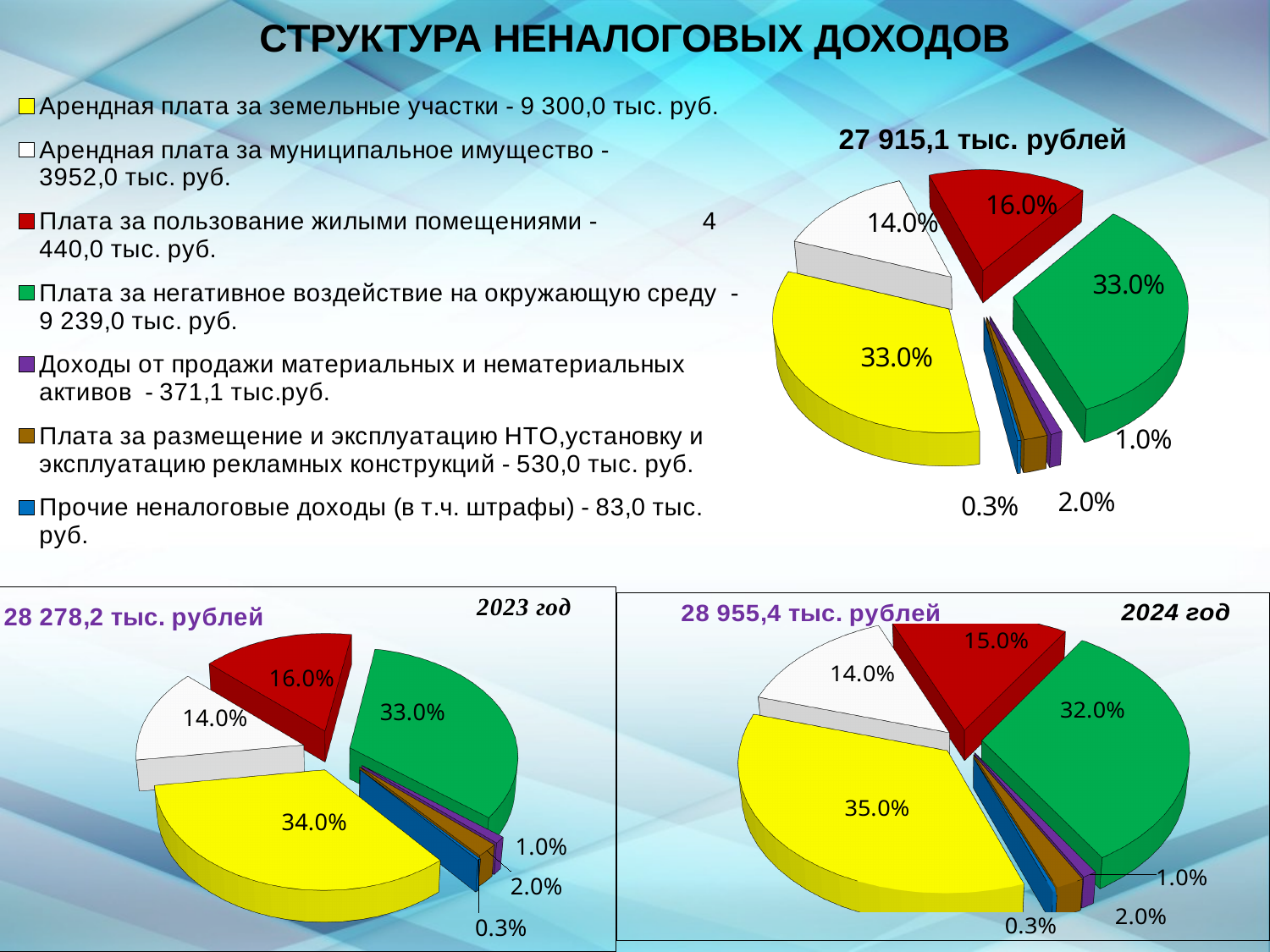
What kind of chart is used on this slide to show the structure of non-tax revenues? pie chart In the top-right pie chart (27 915,1 тыс. рублей), what share is shown for the red slice (Плата за пользование жилыми помещениями)? 16.0% In the 2023 год pie chart, which is larger: the white slice (Арендная плата за муниципальное имущество) or the red slice (Плата за пользование жилыми помещениями)? the red slice (16.0%) In the 2023 год pie chart, what share is shown for the yellow slice (Арендная плата за земельные участки)? 34.0% How many categories does the legend on the left list? 7 What is the title of the slide? СТРУКТУРА НЕНАЛОГОВЫХ ДОХОДОВ How many pie charts are on the slide? 3 In the 2023 год pie chart, which slice has the smallest share? Прочие неналоговые доходы (0.3%) In the 2024 год pie chart, what is the difference between the yellow slice (35.0%) and the green slice (32.0%)? 3.0% What total amount is shown above the 2024 год pie chart? 28 955,4 тыс. рублей In the 2024 год pie chart, what share is shown for the green slice (Плата за негативное воздействие на окружающую среду)? 32.0% In the 2024 год pie chart, which slice has the largest share? Арендная плата за земельные участки (35.0%)